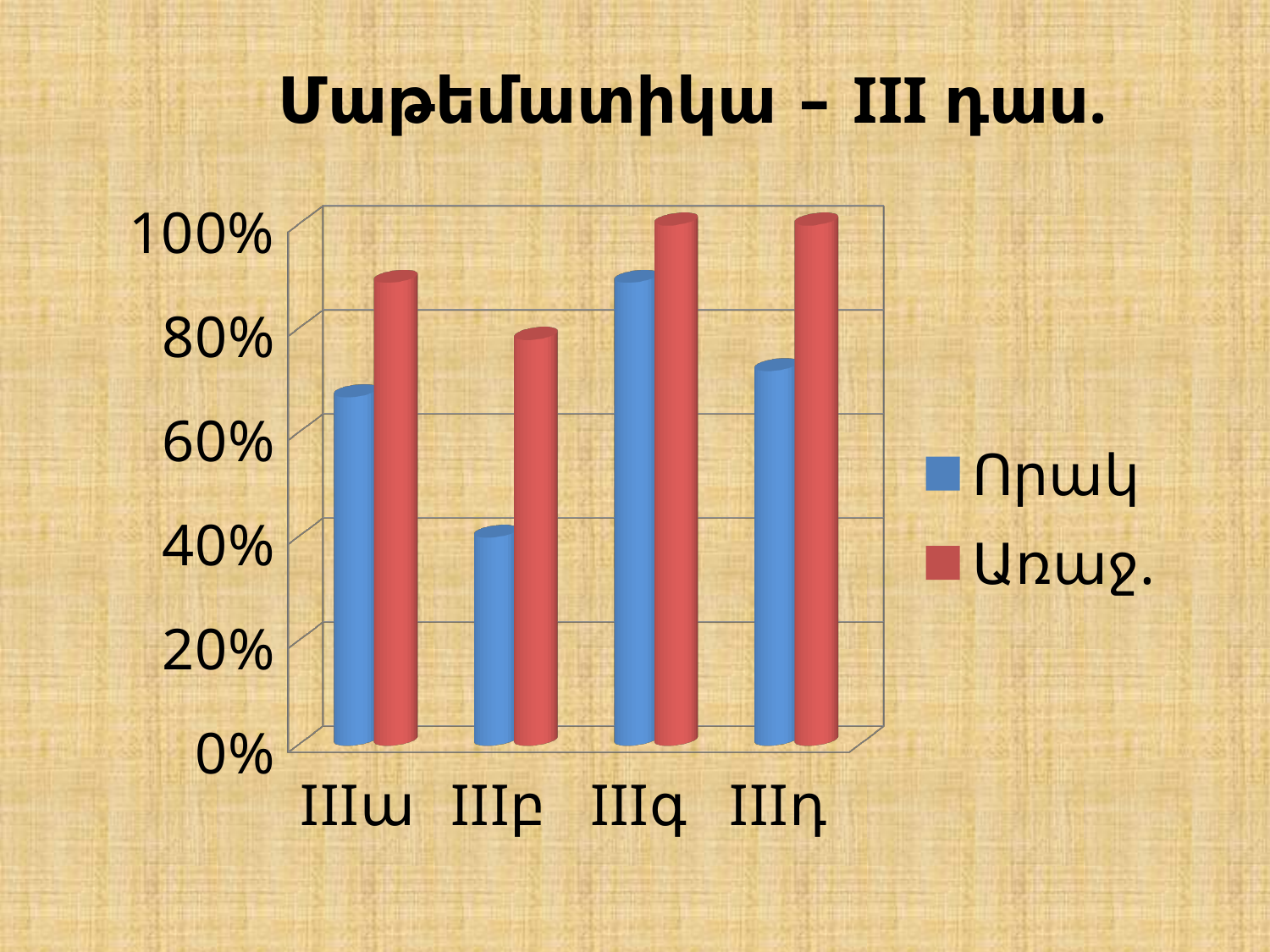
Which category has the highest value for Որակ? IIIգ Is the value for Առաջ. in IIIա greater or less than 80%? greater How many series does the legend list? 2 Is the value for Որակ in IIIդ greater or less than 80%? less What kind of chart is shown on the slide? bar chart Is the value for Որակ in IIIբ greater or less than 60%? less Which category has the lowest value for Առաջ.? IIIբ Which category has the lowest value for Որակ? IIIբ What is the title of the chart? Մաթեմատիկա – III դաս. How many categories are shown on the x axis? 4 In IIIա, which is larger: Որակ or Առաջ.? Առաջ.